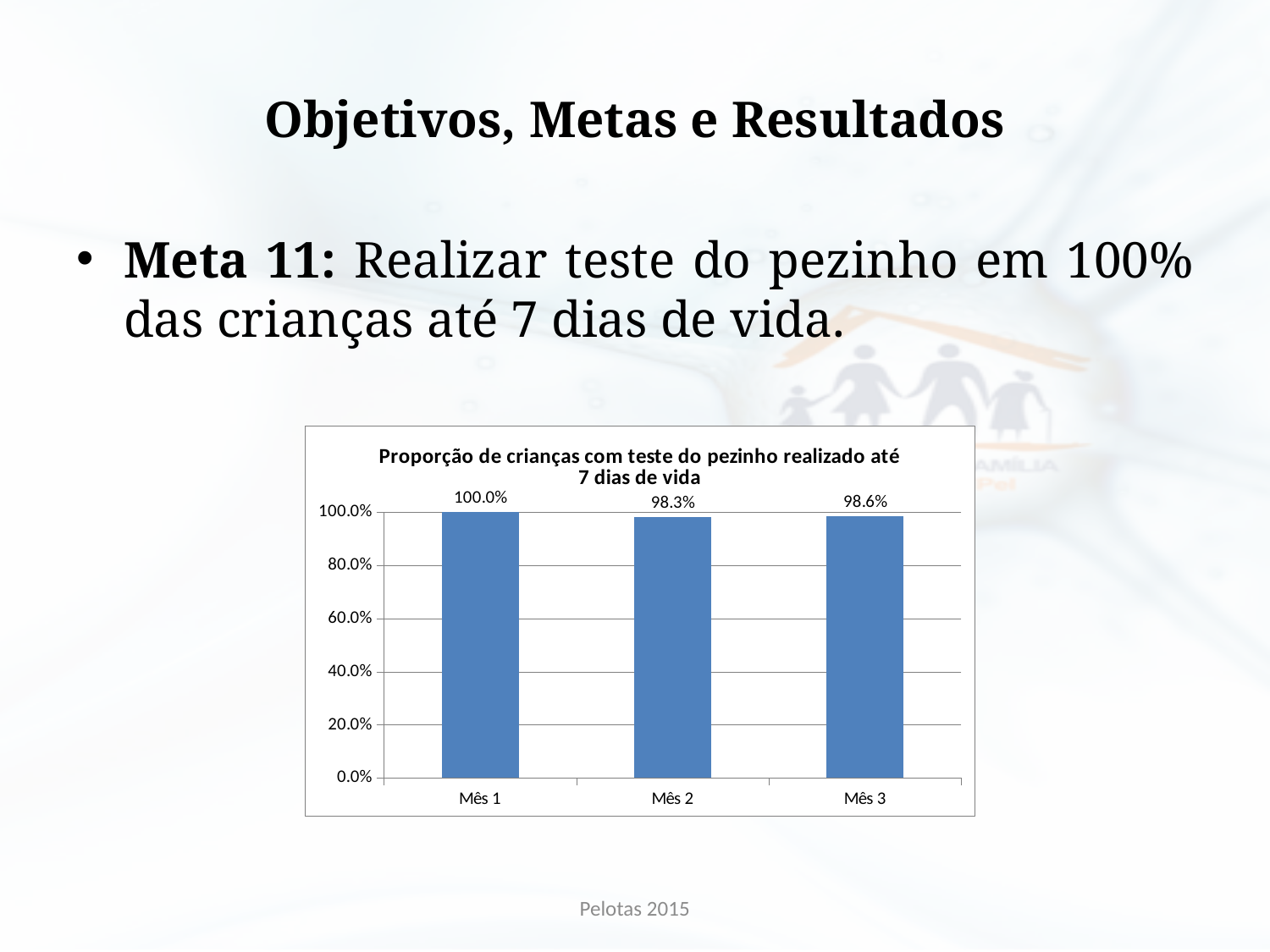
How many months are shown on the x axis? 3 What is the difference between the values for Mês 3 and Mês 2? 0.3% What is the value for Mês 2? 98.3% Which month has the lowest value? Mês 2 What is the title of the chart? Proporção de crianças com teste do pezinho realizado até 7 dias de vida What is the value for Mês 3? 98.6% What is the difference between the values for Mês 1 and Mês 2? 1.7% Is the value for Mês 2 greater or less than 80.0%? greater What is the value for Mês 1? 100.0% Which month has the highest value? Mês 1 What kind of chart is shown on the slide? bar chart Which is larger, the value for Mês 1 or the value for Mês 3? Mês 1